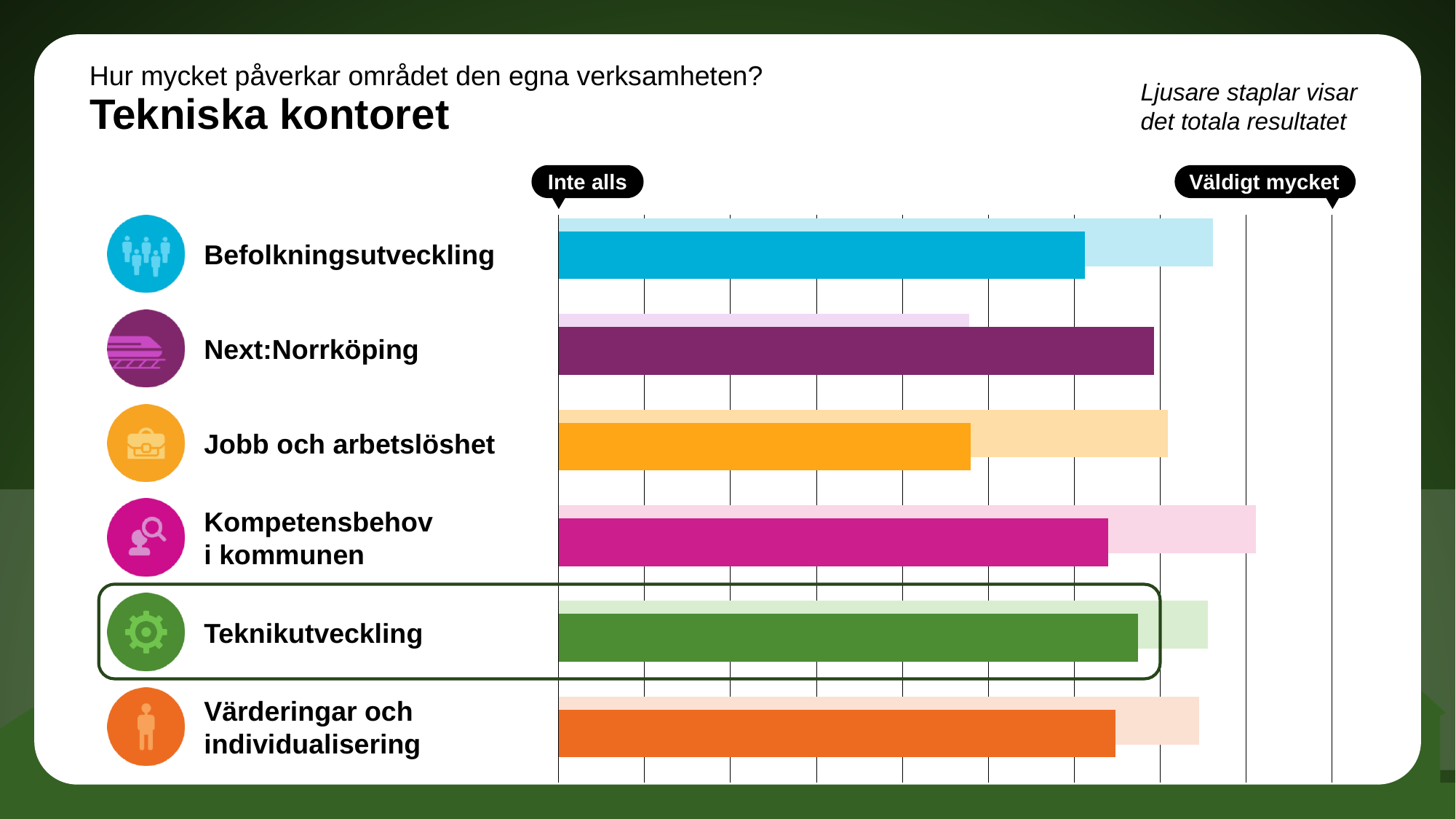
What is the title of the chart? Tekniska kontoret Which dark bar is longer: Next:Norrköping or Jobb och arbetslöshet? Next:Norrköping For Befolkningsutveckling, which bar is longer: the dark bar (Tekniska kontoret) or the light bar (total result)? The light bar (total result) What are the labels at the two ends of the horizontal axis? Inte alls and Väldigt mycket Which category has the shortest light bar (total result)? Next:Norrköping According to the note on the slide, what do the lighter bars show? Det totala resultatet Which category has the shortest dark bar (Tekniska kontoret result)? Jobb och arbetslöshet For Next:Norrköping, which bar is longer: the dark bar (Tekniska kontoret) or the light bar (total result)? The dark bar (Tekniska kontoret) Which category has the longest light bar (total result)? Kompetensbehov i kommunen How many categories (areas) are shown in the chart? 6 What kind of chart is shown on the slide? Bar chart